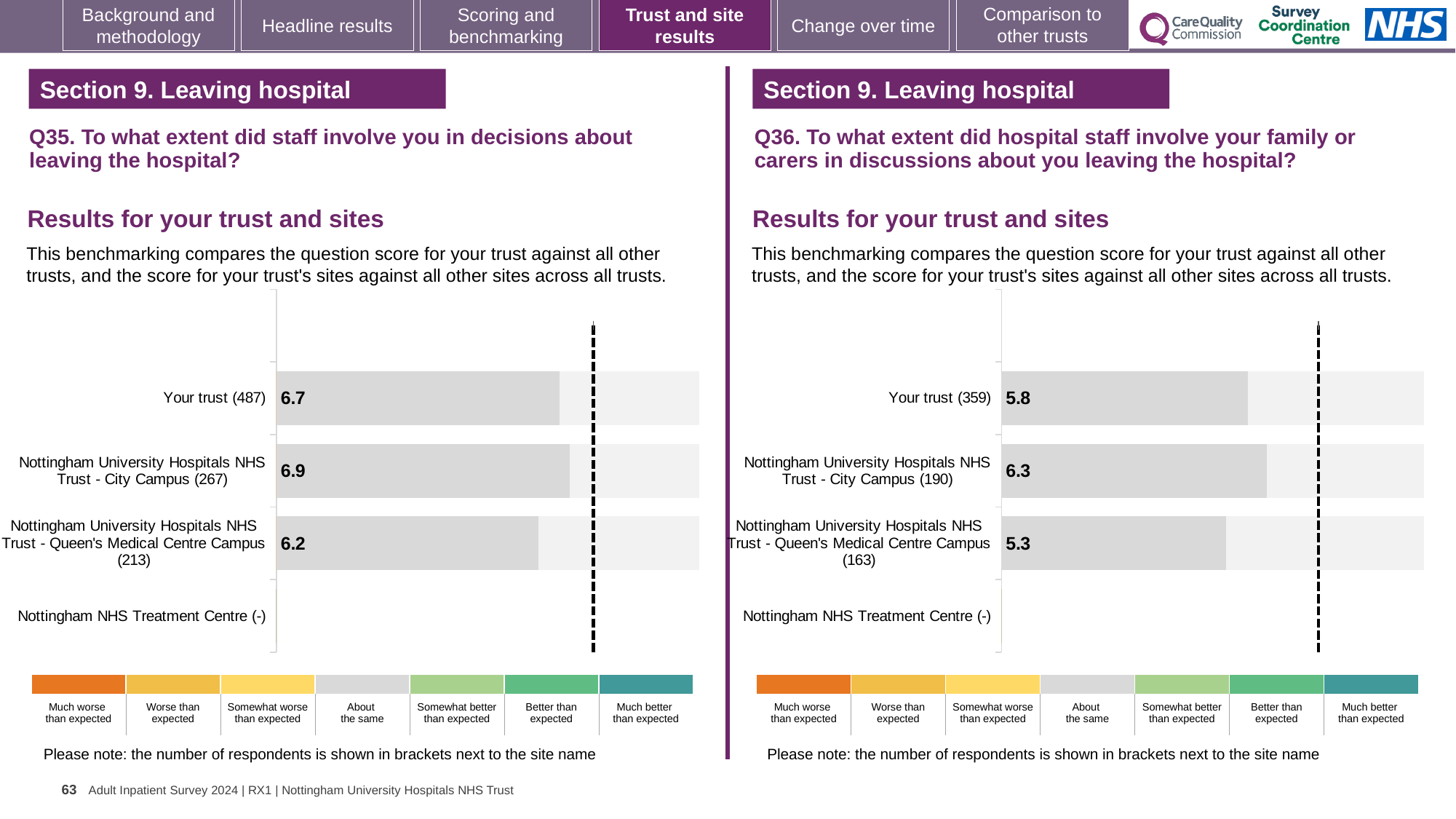
On the Q35 chart (left), which site or trust has the lowest score? Nottingham University Hospitals NHS Trust - Queen's Medical Centre Campus On the Q36 chart (right), which is larger: the score for Your trust or the score for City Campus? City Campus How many respondents are shown in brackets for Your trust on the Q35 chart (left)? 487 On the Q36 chart (right), which site or trust has the highest score? Nottingham University Hospitals NHS Trust - City Campus On the Q36 chart (right), what is the score for Your trust? 5.8 What kind of chart is used on the Q35 chart (left)? Bar chart On the Q35 chart (left), what is the difference between the City Campus score and the Queen's Medical Centre Campus score? 0.7 On the Q36 chart (right), what is the difference between the Your trust score and the Queen's Medical Centre Campus score? 0.5 On the Q35 chart (left), what is the score for Your trust? 6.7 How many categories (rows) are listed on the Q36 chart (right)? 4 On the Q36 chart (right), what is the score for Nottingham University Hospitals NHS Trust - Queen's Medical Centre Campus? 5.3 On the Q35 chart (left), what is the score for Nottingham University Hospitals NHS Trust - City Campus? 6.9